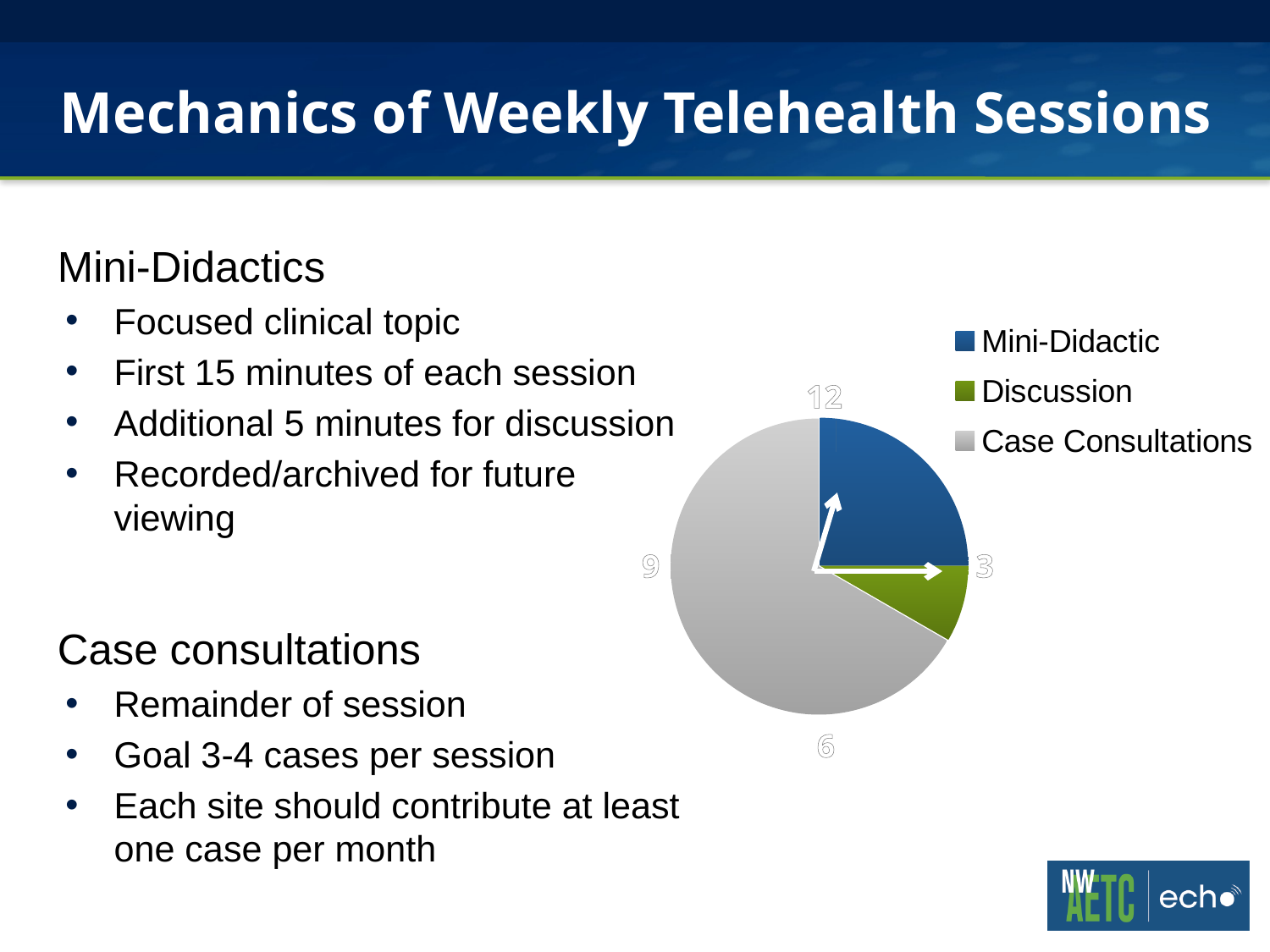
Which legend entry is shown in green in the pie chart? Discussion Which category takes up the smallest share of the pie chart? Discussion What colour represents Mini-Didactic in the pie chart? blue Which slice is larger in the pie chart, Case Consultations or Mini-Didactic? Case Consultations How many slices does the pie chart have? 3 What kind of chart is shown on the slide? pie chart How many entries does the legend of the pie chart list? 3 Which slice is larger in the pie chart, Mini-Didactic or Discussion? Mini-Didactic Which category takes up the largest share of the pie chart? Case Consultations Which slice is larger in the pie chart, Discussion or Case Consultations? Case Consultations